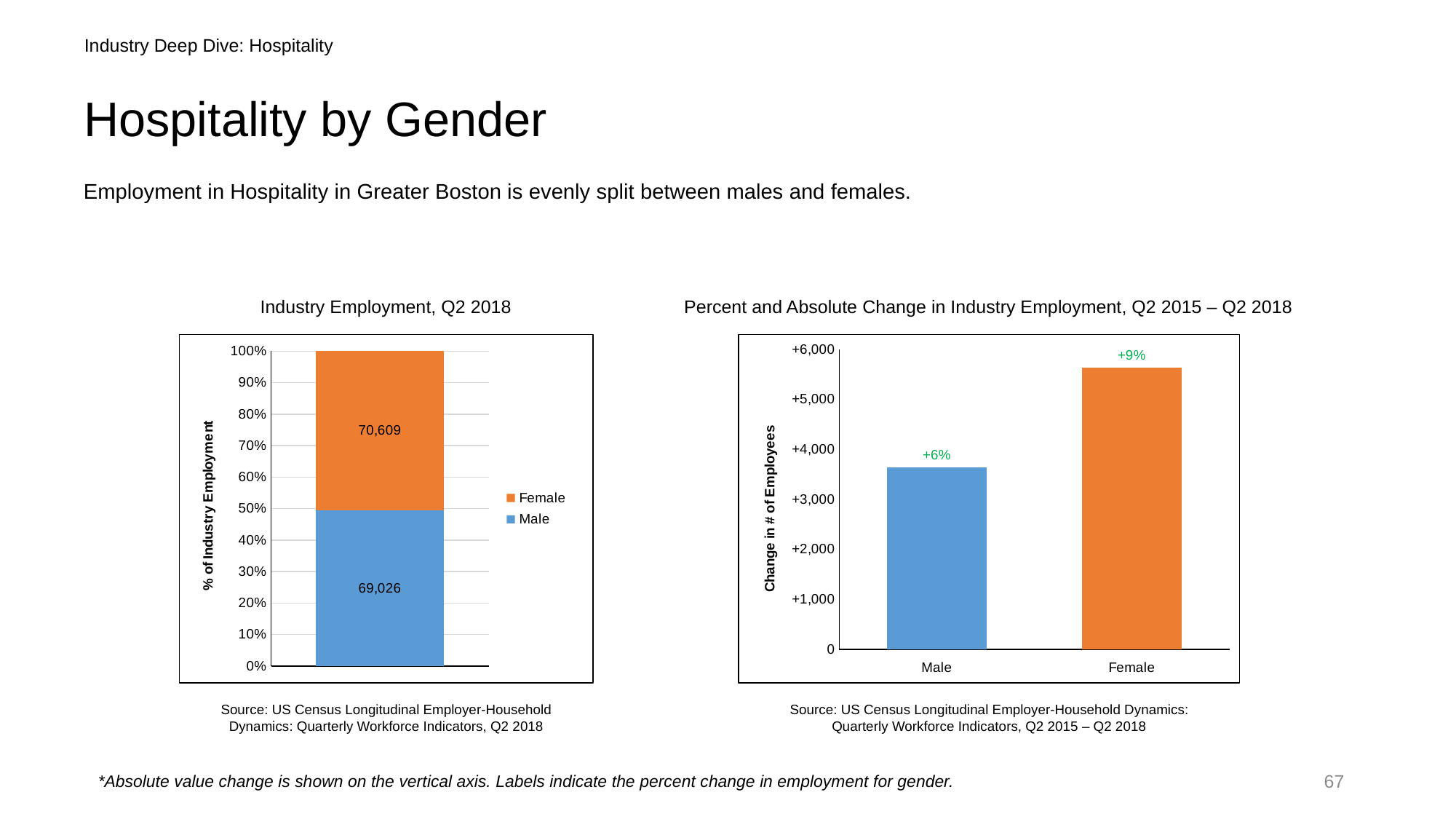
In the 'Percent and Absolute Change in Industry Employment, Q2 2015 – Q2 2018' chart, is the value for Male greater or less than +4,000? less In the 'Industry Employment, Q2 2018' chart, what value is labelled on the Female segment? 70,609 In the 'Industry Employment, Q2 2018' chart, what value is labelled on the Male segment? 69,026 How many series does the legend of the 'Industry Employment, Q2 2018' chart list? 2 What kind of chart is the 'Industry Employment, Q2 2018' chart? Stacked bar chart In the 'Percent and Absolute Change in Industry Employment, Q2 2015 – Q2 2018' chart, which category has the highest bar? Female In the 'Percent and Absolute Change in Industry Employment, Q2 2015 – Q2 2018' chart, is the value for Female greater or less than +5,000? greater In the 'Percent and Absolute Change in Industry Employment, Q2 2015 – Q2 2018' chart, what percent change label is shown above the Female bar? +9% In the 'Percent and Absolute Change in Industry Employment, Q2 2015 – Q2 2018' chart, what percent change label is shown above the Male bar? +6% In the 'Industry Employment, Q2 2018' chart, what is the difference between the Female and Male values? 1,583 In the 'Industry Employment, Q2 2018' chart, which segment has the larger labelled value, Female or Male? Female What is the vertical axis title of the 'Percent and Absolute Change in Industry Employment, Q2 2015 – Q2 2018' chart? Change in # of Employees